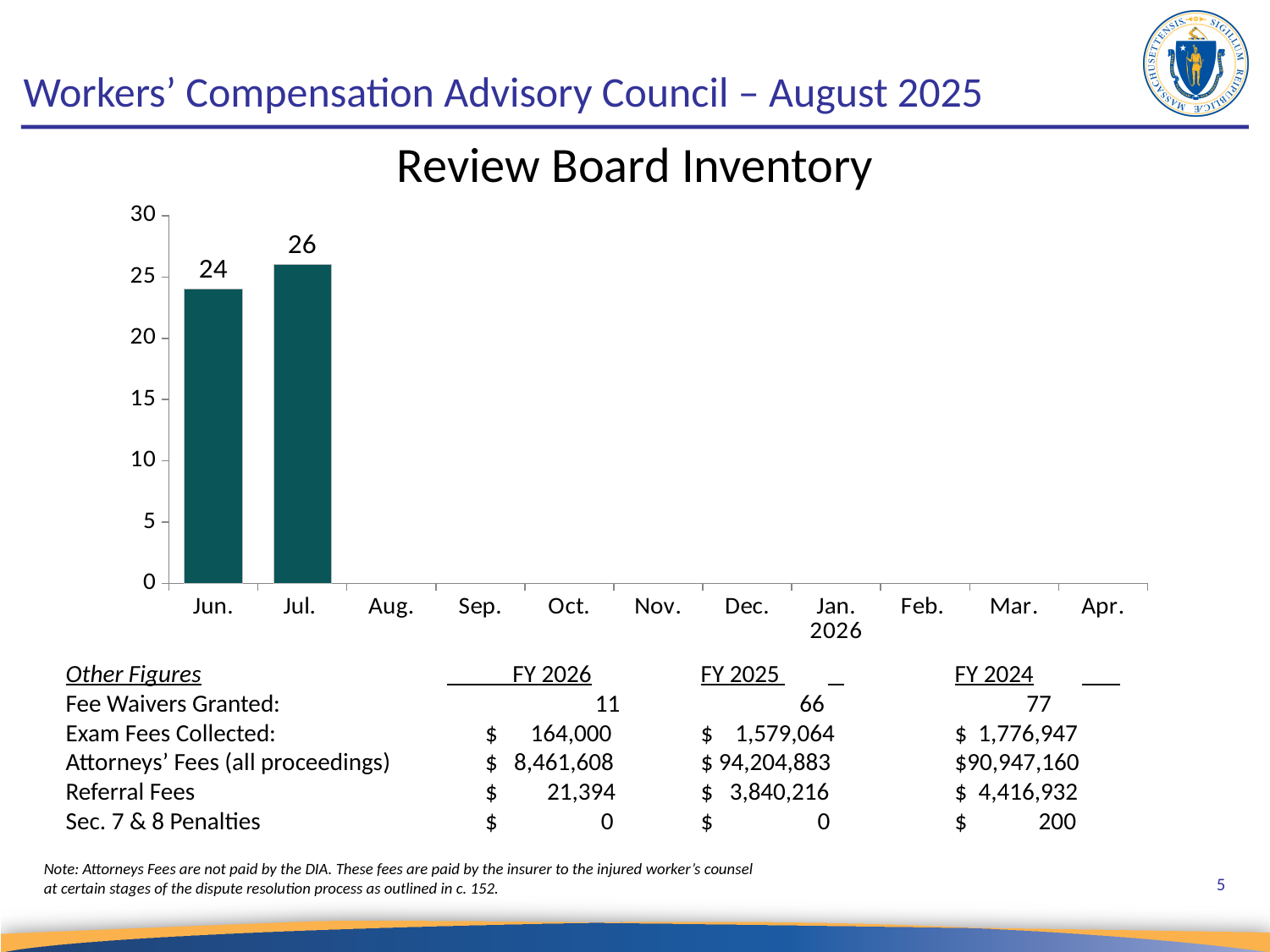
How many month categories are shown on the x axis of the Review Board Inventory chart? 11 What is the Review Board Inventory value for Jun.? 24 How many months have a bar plotted in the Review Board Inventory chart? 2 What is the Review Board Inventory value for Jul.? 26 What is the difference between the Jul. and Jun. values in the Review Board Inventory chart? 2 What kind of chart is the Review Board Inventory chart? Bar chart Do the plotted values in the Review Board Inventory chart rise or fall from Jun. to Jul.? Rise Which month has the highest plotted value in the Review Board Inventory chart? Jul. Which is larger in the Review Board Inventory chart, the value for Jun. or the value for Jul.? Jul. Is the value for Jul. in the Review Board Inventory chart greater or less than 30? less Which month has the lowest plotted value in the Review Board Inventory chart? Jun. Is the value for Jun. in the Review Board Inventory chart greater or less than 20? greater